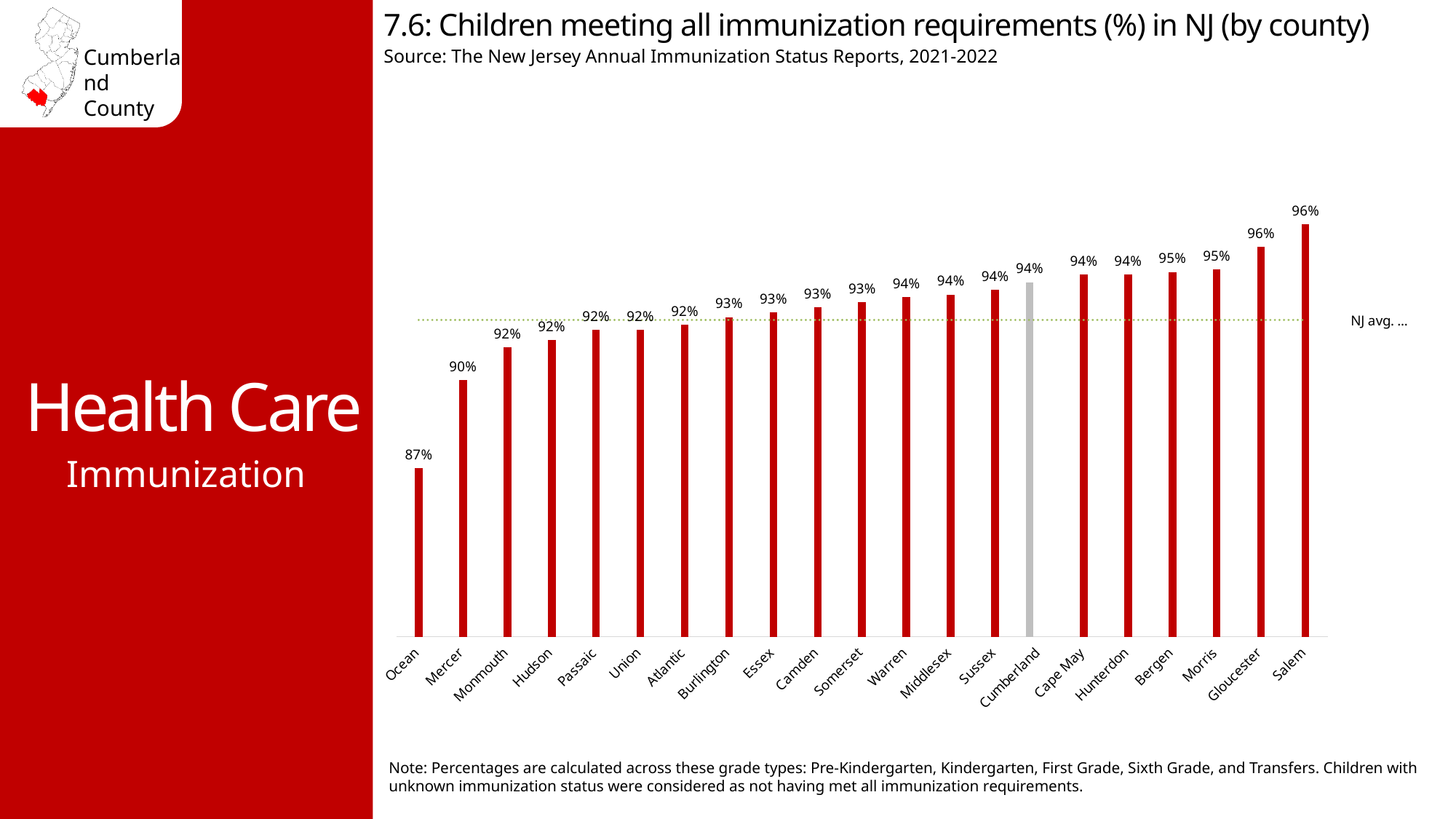
What is the difference in percentage points between Mercer and Ocean? 3 percentage points What is the value shown for Gloucester County? 96% What kind of chart is shown on the slide? Bar chart Which county has the lowest percentage of children meeting all immunization requirements? Ocean What is the value shown for Ocean County? 87% What is the difference in percentage points between Salem (96%) and Ocean (87%)? 9 percentage points Do the values generally rise or fall from left to right across the counties? Rise What percentage is shown for Mercer County? 90% How many counties are shown on the chart? 21 Which has a higher value, Cumberland or Ocean? Cumberland What percentage of children in Cumberland County met all immunization requirements? 94% Which has a higher value, Ocean or Mercer? Mercer